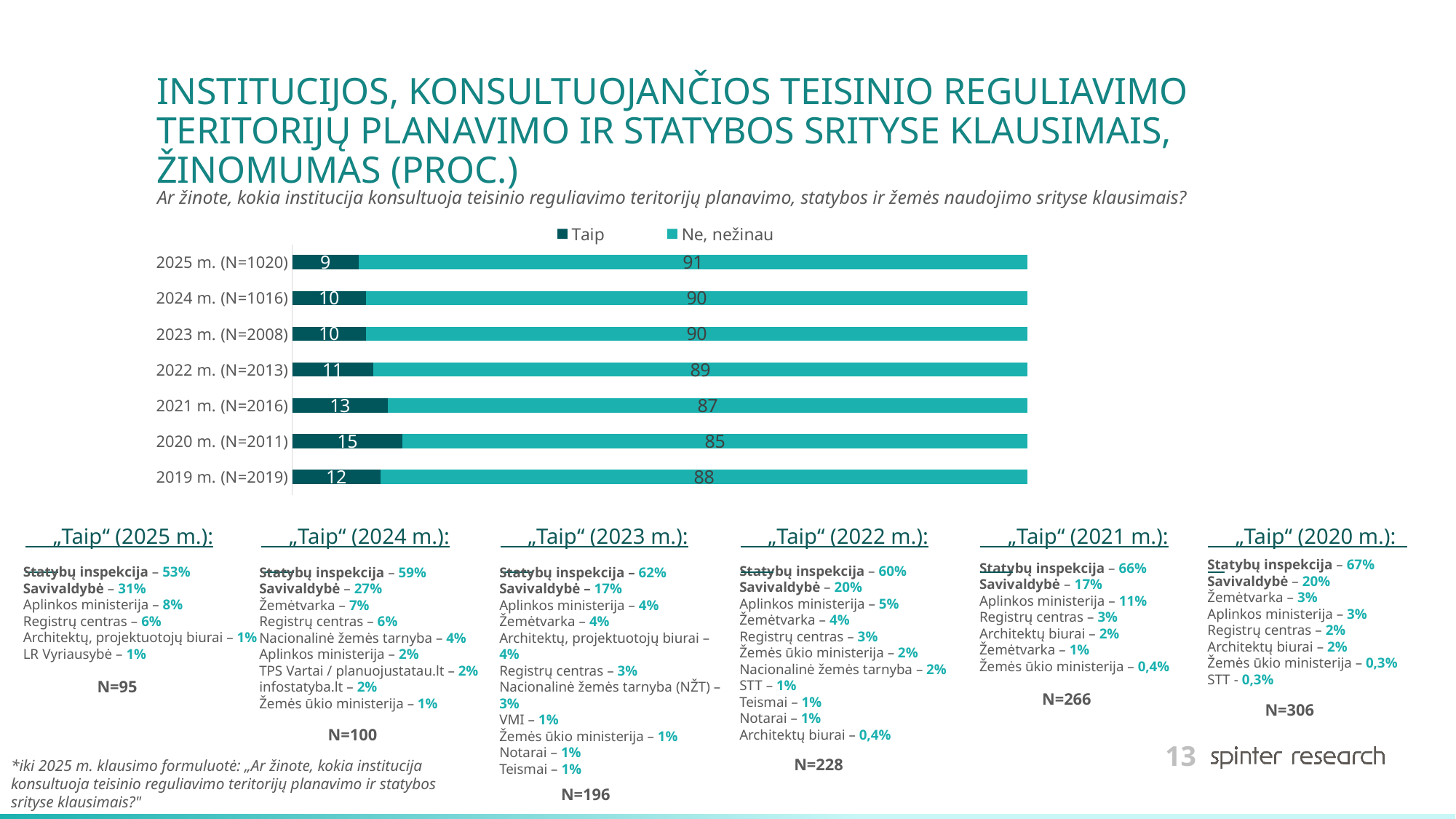
How many years (categories) are shown in the chart? 7 How many series does the legend list? 2 Which year has the lowest "Taip" value? 2025 m. (N=1020) What is the total of the stacked bar for 2023 m. (N=2008)? 100 What is the value for "Taip" in 2025 m. (N=1020)? 9 What kind of chart is shown on the slide? Stacked bar chart What is the value for "Ne, nežinau" in 2020 m. (N=2011)? 85 Which is larger: the "Taip" value for 2019 m. or for 2022 m.? 2019 m. What are the two legend entries of the chart? Taip; Ne, nežinau Which year has the highest "Taip" value? 2020 m. (N=2011) What is the value for "Taip" in 2021 m. (N=2016)? 13 What is the difference between the "Ne, nežinau" values for 2025 m. and 2020 m.? 6